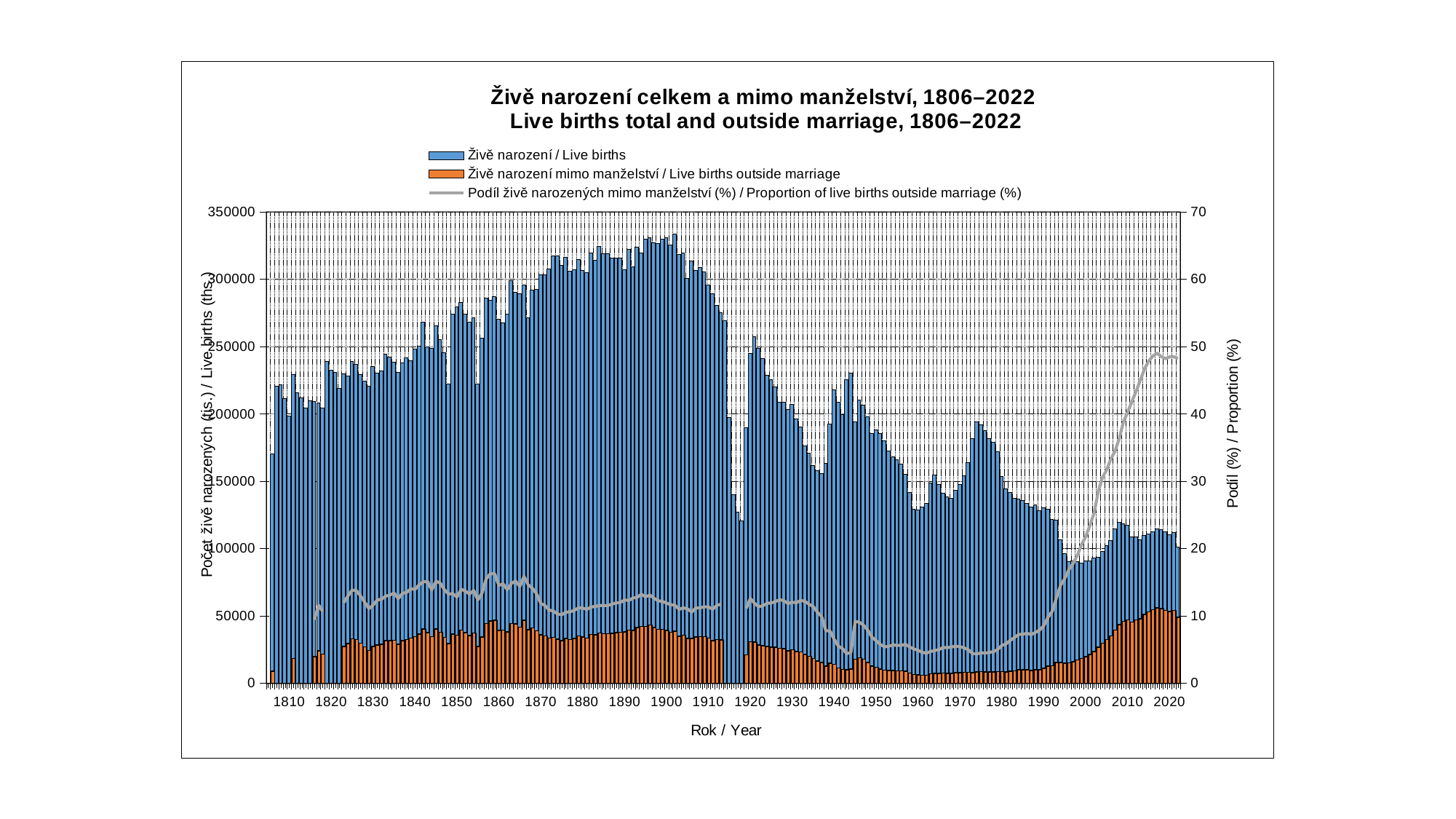
Does the proportion of live births outside marriage rise or fall between 1990 and 2020? rise How many series does the legend list? 3 Is the value for live births (Živě narození) in 1900 greater or less than 300000? greater What is the label of the x axis? Rok / Year What kind of chart is shown on the slide? bar chart with a line Is the proportion of live births outside marriage in 2020 greater or less than 40? greater Which year has more live births in total, 1900 or 2000? 1900 Do total live births rise or fall between 1900 and 1920? fall Is the value for live births (Živě narození) in 1990 greater or less than 150000? less Which series is drawn as a grey line? Podíl živě narozených mimo manželství (%) / Proportion of live births outside marriage (%)